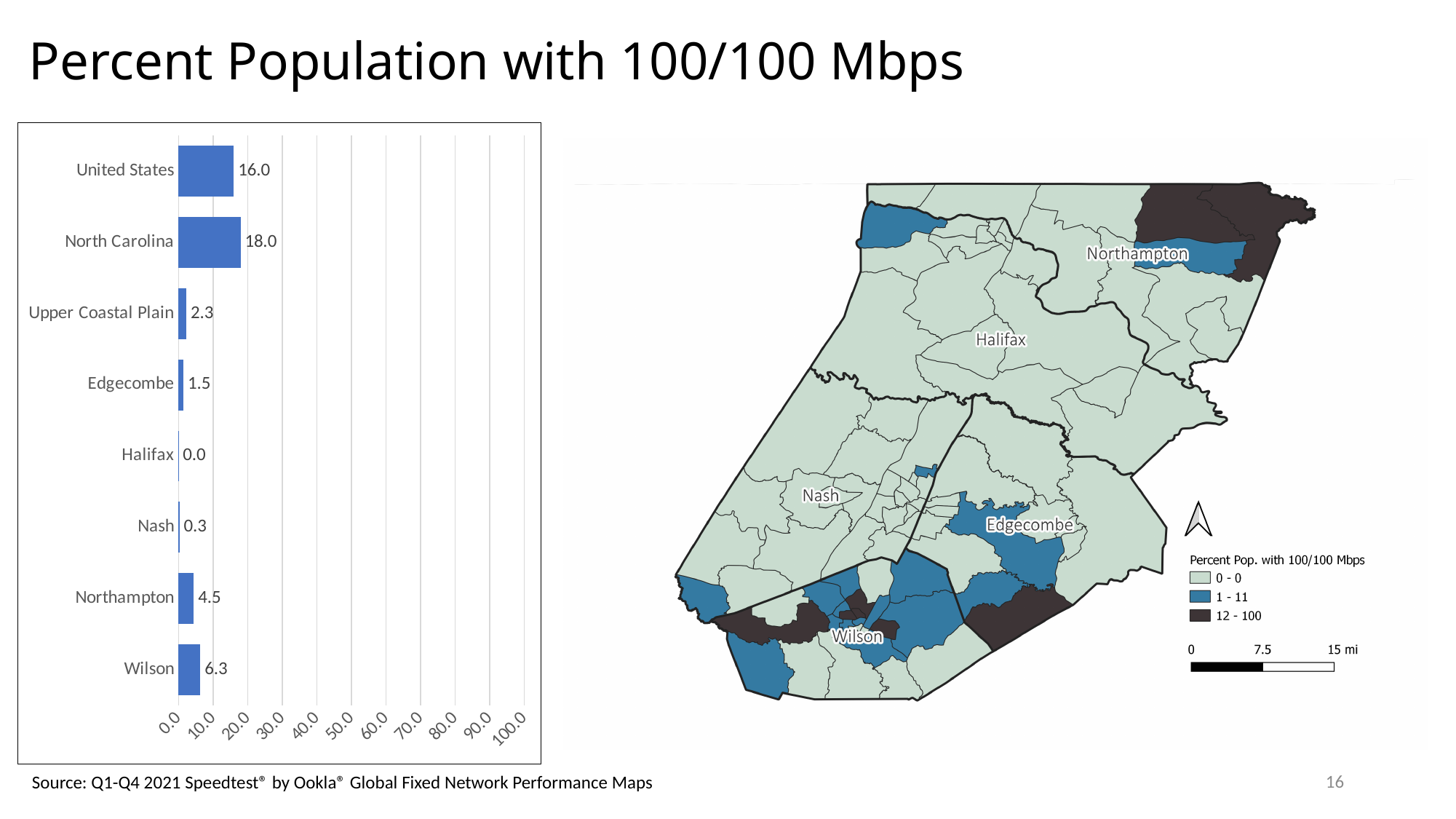
How many categories are shown in the bar chart? 8 Which category has the highest value in the bar chart? North Carolina What is the value for Upper Coastal Plain in the bar chart? 2.3 What is the difference between the values for North Carolina and the United States in the bar chart? 2.0 What is the value for Wilson in the bar chart? 6.3 Which category has the lowest value in the bar chart? Halifax Is the value for Wilson in the bar chart greater or less than 10.0? less What is the value for Halifax in the bar chart? 0.0 What is the difference between the values for Wilson and Northampton in the bar chart? 1.8 What kind of chart is shown on the left of the slide? Bar chart What is the value for North Carolina in the bar chart? 18.0 Which has a larger value in the bar chart, Northampton or Edgecombe? Northampton